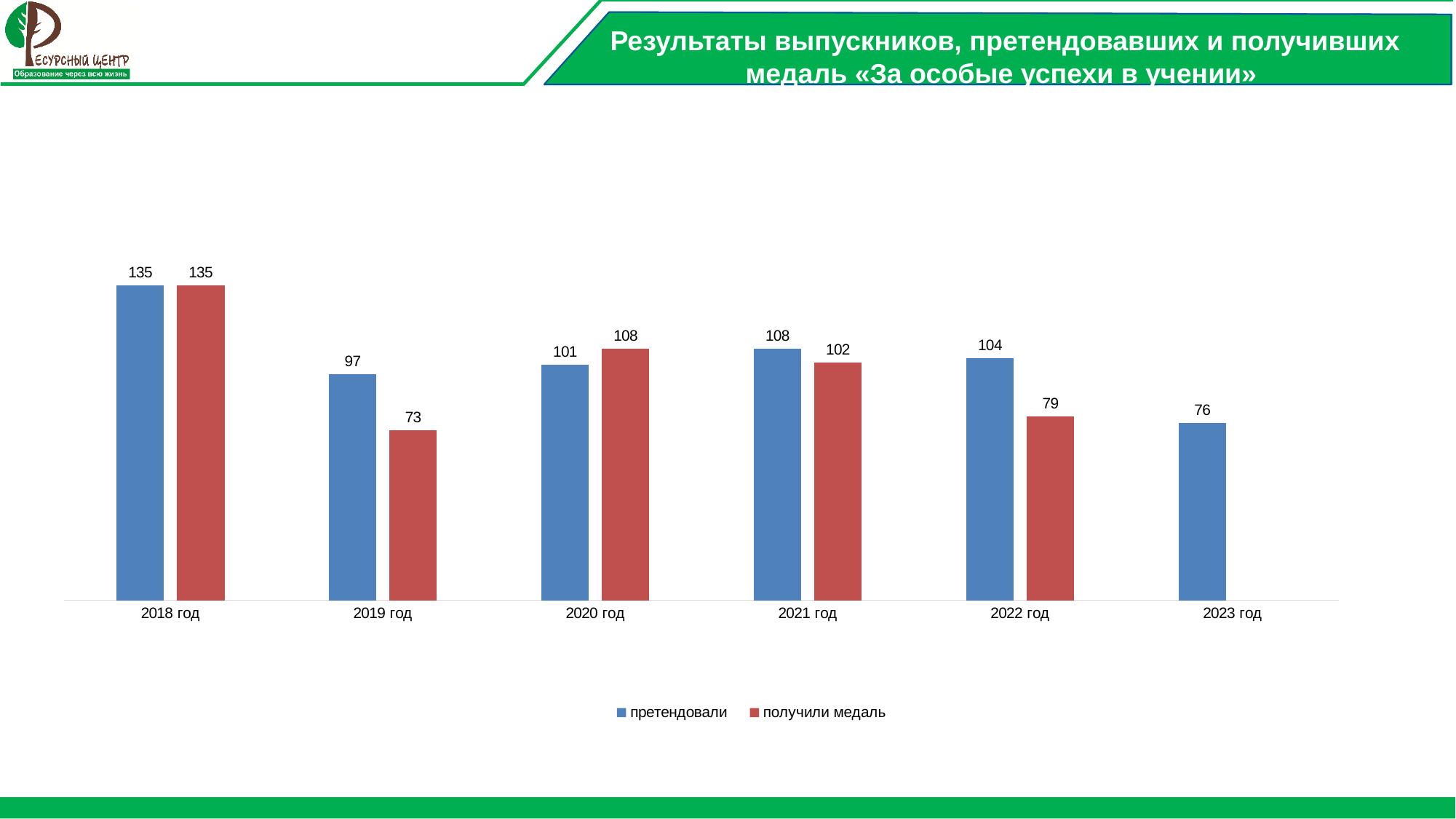
Which year has the highest value for "получили медаль"? 2018 год What is the value for "претендовали" in 2023 год? 76 What is the value for "претендовали" in 2019 год? 97 Which colour represents the "получили медаль" series? red How many series does the legend list? 2 In 2020 год, which is larger: "претендовали" or "получили медаль"? получили медаль What is the difference between "претендовали" and "получили медаль" in 2019 год? 24 What is the difference between "претендовали" and "получили медаль" in 2022 год? 25 What kind of chart is shown on the slide? bar chart How many years are shown on the x axis? 6 Which year has the lowest value for "претендовали"? 2023 год What is the value for "получили медаль" in 2022 год? 79